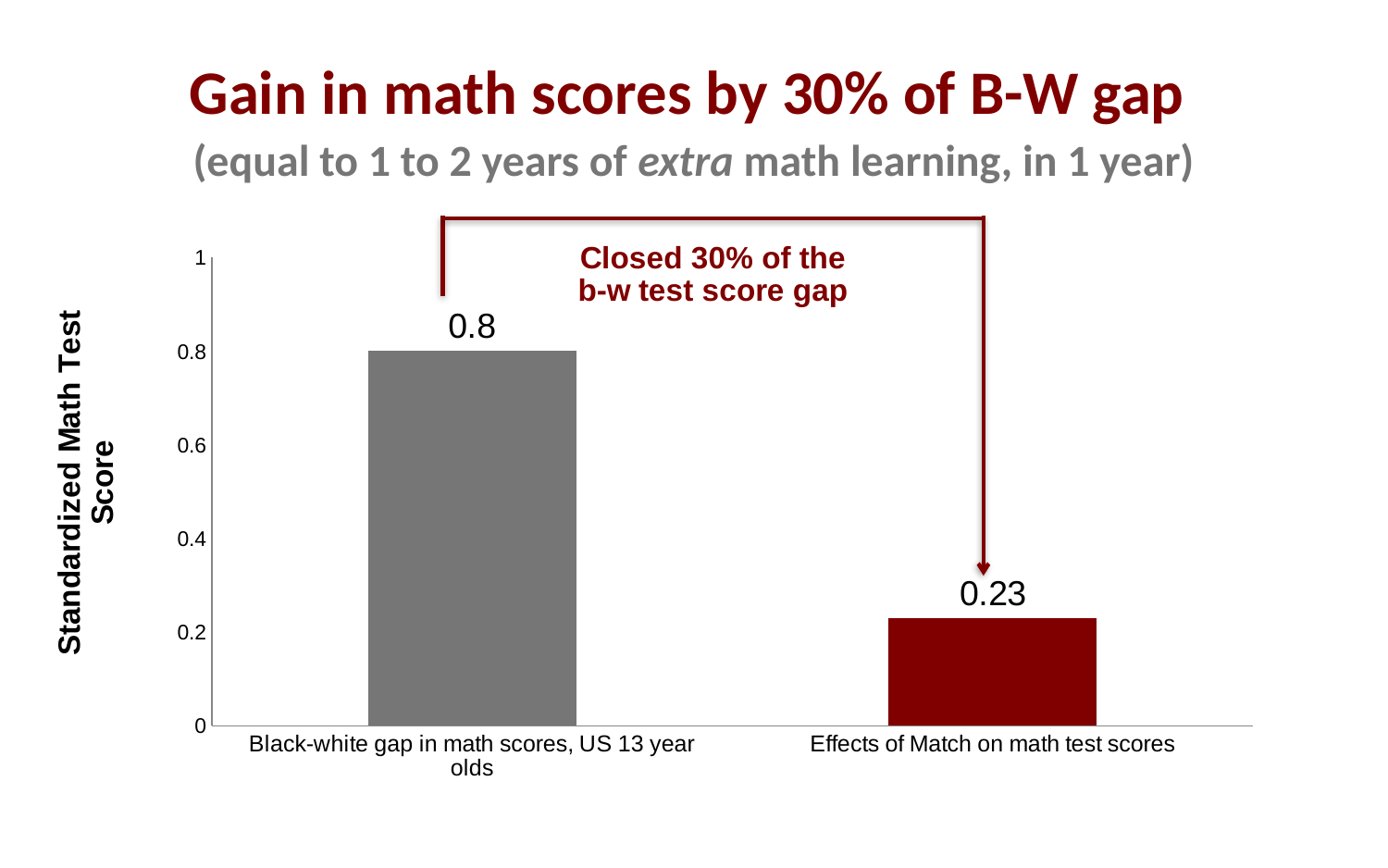
Is the value for "Black-white gap in math scores, US 13 year olds" greater or less than 0.6? greater Is the value for "Effects of Match on math test scores" greater or less than 0.4? less Which category has the highest value? Black-white gap in math scores, US 13 year olds Which category has the lowest value? Effects of Match on math test scores What is the label of the vertical axis? Standardized Math Test Score What is the difference between the value for "Black-white gap in math scores, US 13 year olds" and the value for "Effects of Match on math test scores"? 0.57 What kind of chart is shown on the slide? bar chart How many categories are shown on the chart? 2 What is the value for "Black-white gap in math scores, US 13 year olds"? 0.8 Which is larger: the value for "Black-white gap in math scores, US 13 year olds" or the value for "Effects of Match on math test scores"? Black-white gap in math scores, US 13 year olds What is the value for "Effects of Match on math test scores"? 0.23 What does the annotation between the two bars say? Closed 30% of the b-w test score gap